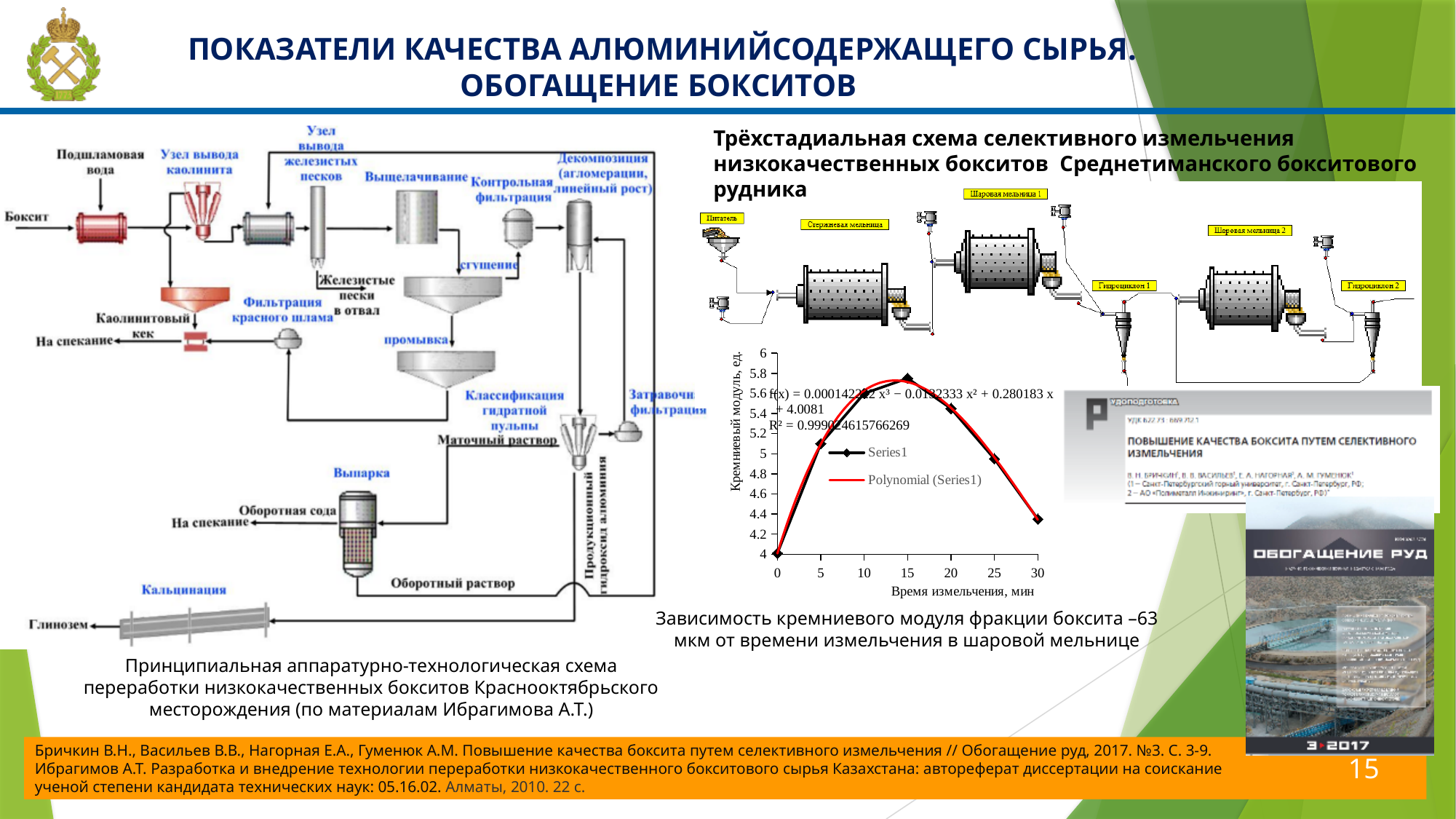
Is the value for 5 min greater or less than 4.8? greater How does the silicon modulus change as grinding time increases from 15 to 30 min? it falls What is the R² value printed on the chart? 0.99924615766269 How many data points are plotted for Series1? 7 Which has the higher silicon modulus: 10 min or 30 min? 10 min At which grinding time (min) is the silicon modulus lowest? 0 How many entries does the chart legend list? 2 Is the value for 15 min greater or less than 5.6? greater Is the value for 30 min greater or less than 4.6? less What is the label of the x axis of the chart? Время измельчения, мин At which grinding time (min) does the silicon modulus reach its highest value? 15 What kind of chart is shown on the slide? line chart